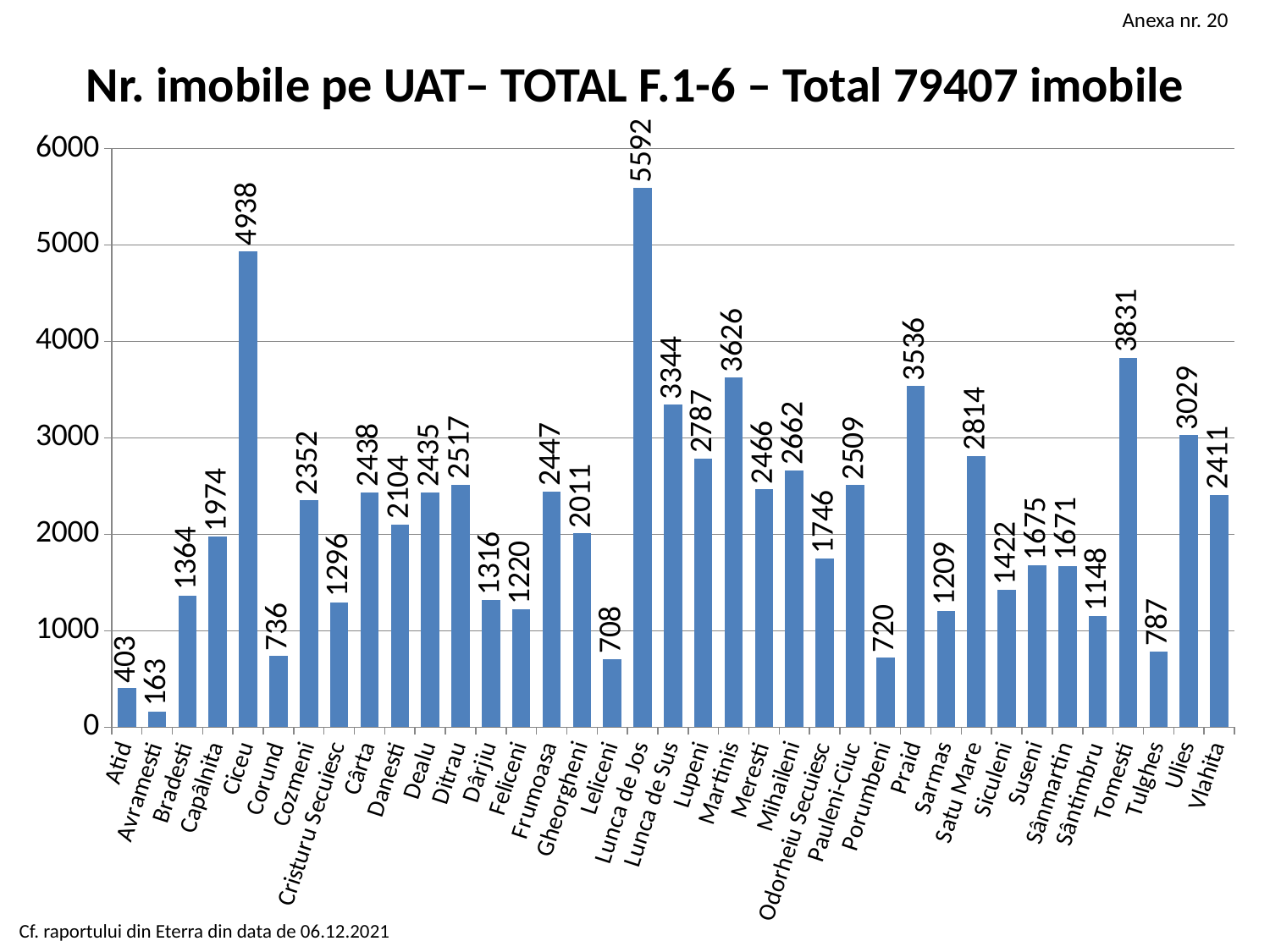
What is the value for Odorheiu Secuiesc? 1746 What is the value for Lunca de Jos? 5592 What is the title of the chart? Nr. imobile pe UAT– TOTAL F.1-6 – Total 79407 imobile What is the difference between the values for Ciceu and Tomesti? 1107 What is the difference between the values for Suseni and Sânmartin? 4 Which category has the highest value? Lunca de Jos Is the value for Ulies greater or less than 3000? greater Which category has the lowest value? Avramesti What kind of chart is shown on the slide? bar chart What is the value for Praid? 3536 Which is larger, the value for Martinis or the value for Lunca de Sus? Martinis How many categories are shown on the x axis? 37